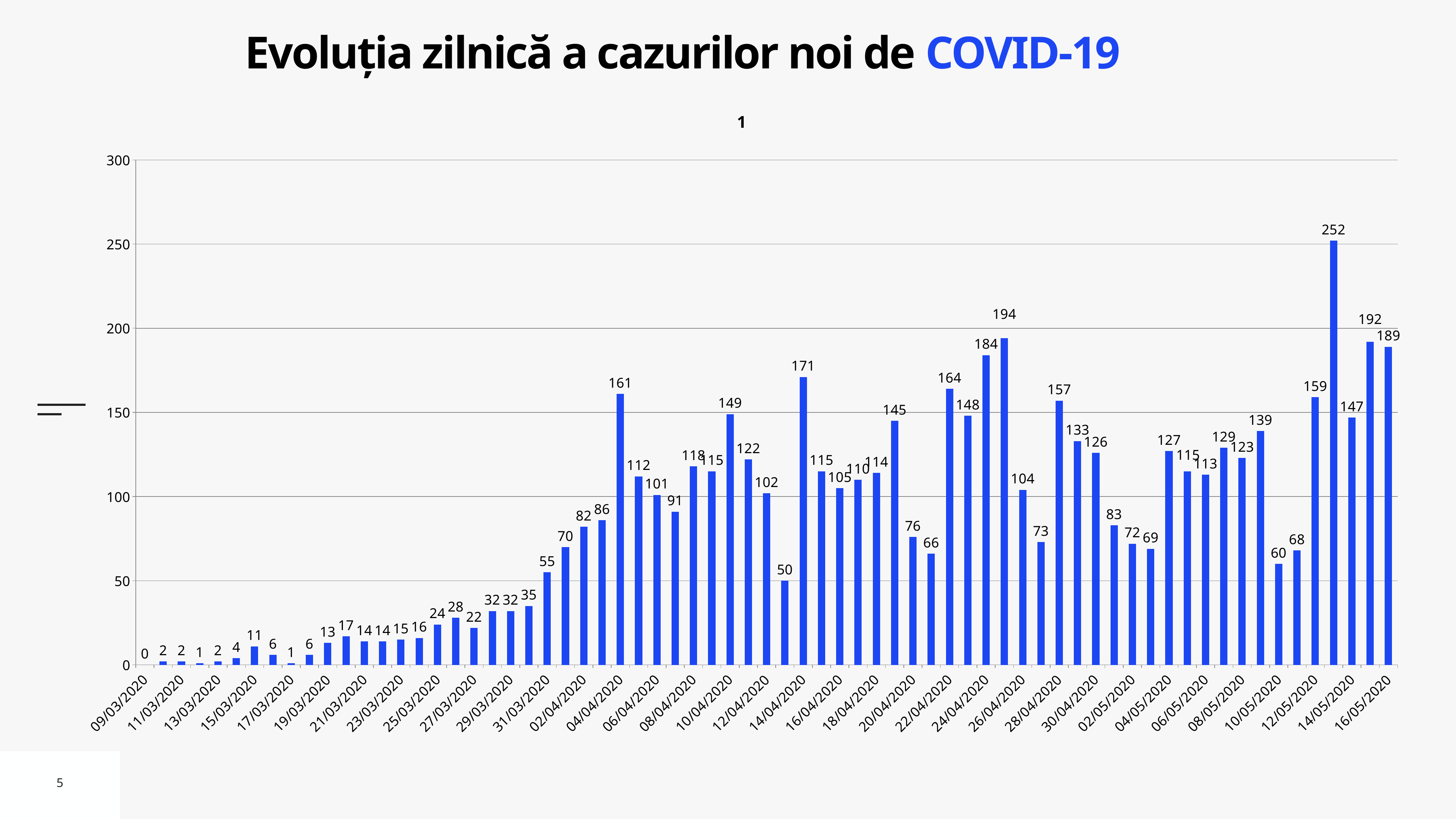
Which date has the lowest value in the chart? 09/03/2020 What is the difference between the values for 16/05/2020 and 14/05/2020? 42 What is the title of the slide? Evoluția zilnică a cazurilor noi de COVID-19 What is the value for 04/04/2020? 161 Which is larger, the value for 22/04/2020 or the value for 28/04/2020? 22/04/2020 What is the value for 31/03/2020? 55 What is the value for 14/04/2020? 171 What is the value for 16/05/2020? 189 How many bars are plotted in the chart? 69 Is the value for 10/05/2020 greater or less than 100? less What is the highest value shown in the chart? 252 What type of chart is shown on the slide? bar chart